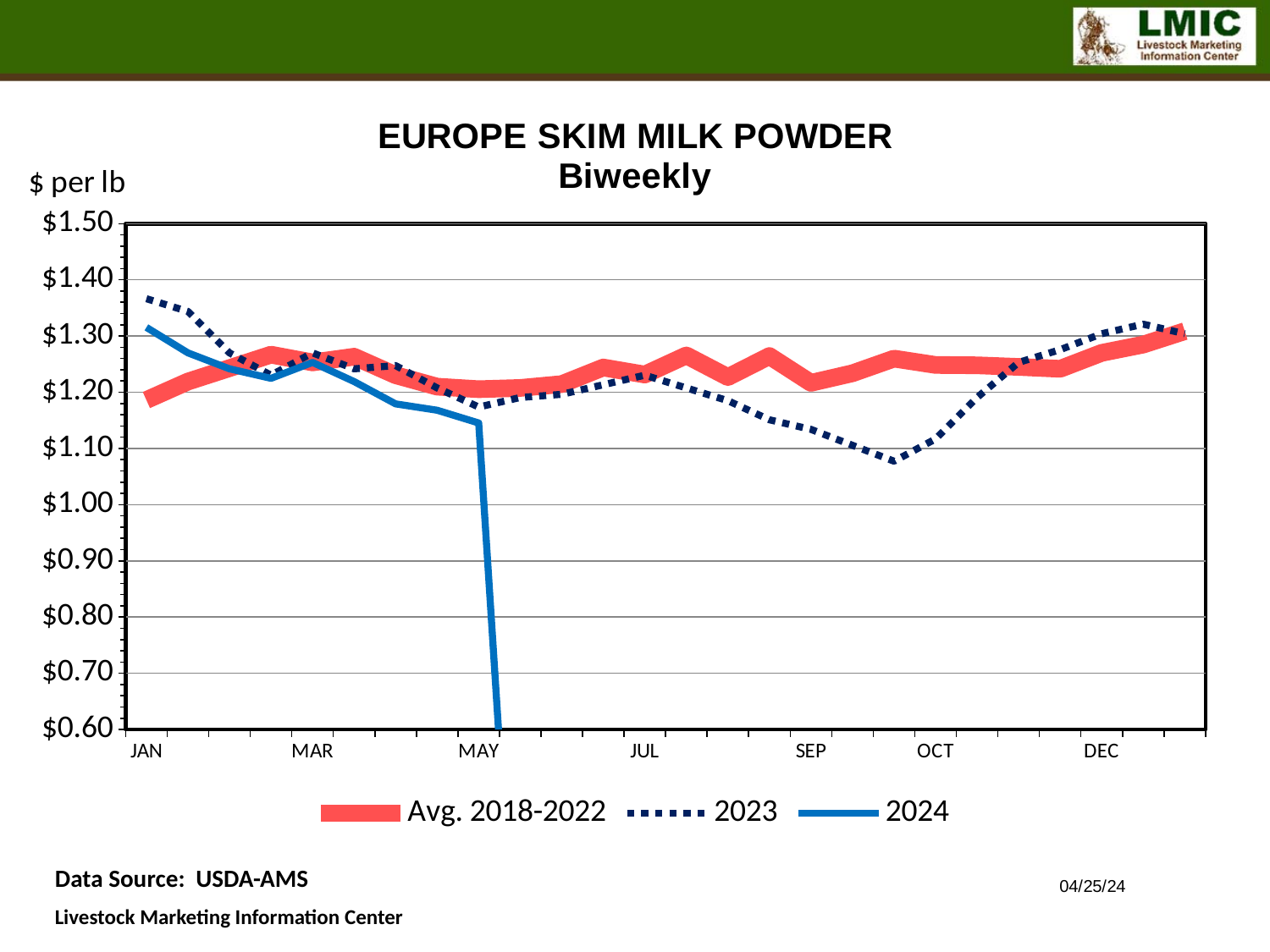
Is the value of the 2024 line in MAY greater or less than $1.20? less How many series does the legend list? 3 What unit is shown on the y axis of the chart? $ per lb What kind of chart is shown on the slide? Line chart Does the 2024 line rise or fall from JAN to MAY? fall Does the Avg. 2018-2022 line rise or fall from JAN to MAR? rise Is the value of the 2023 line in JAN greater or less than $1.30? greater In SEP, which is higher: the 2023 line or the Avg. 2018-2022 line? Avg. 2018-2022 What is the title of the chart? EUROPE SKIM MILK POWDER Biweekly Is the lowest point of the 2023 line greater or less than $1.20? less In JAN, which is higher: the 2023 line or the Avg. 2018-2022 line? 2023